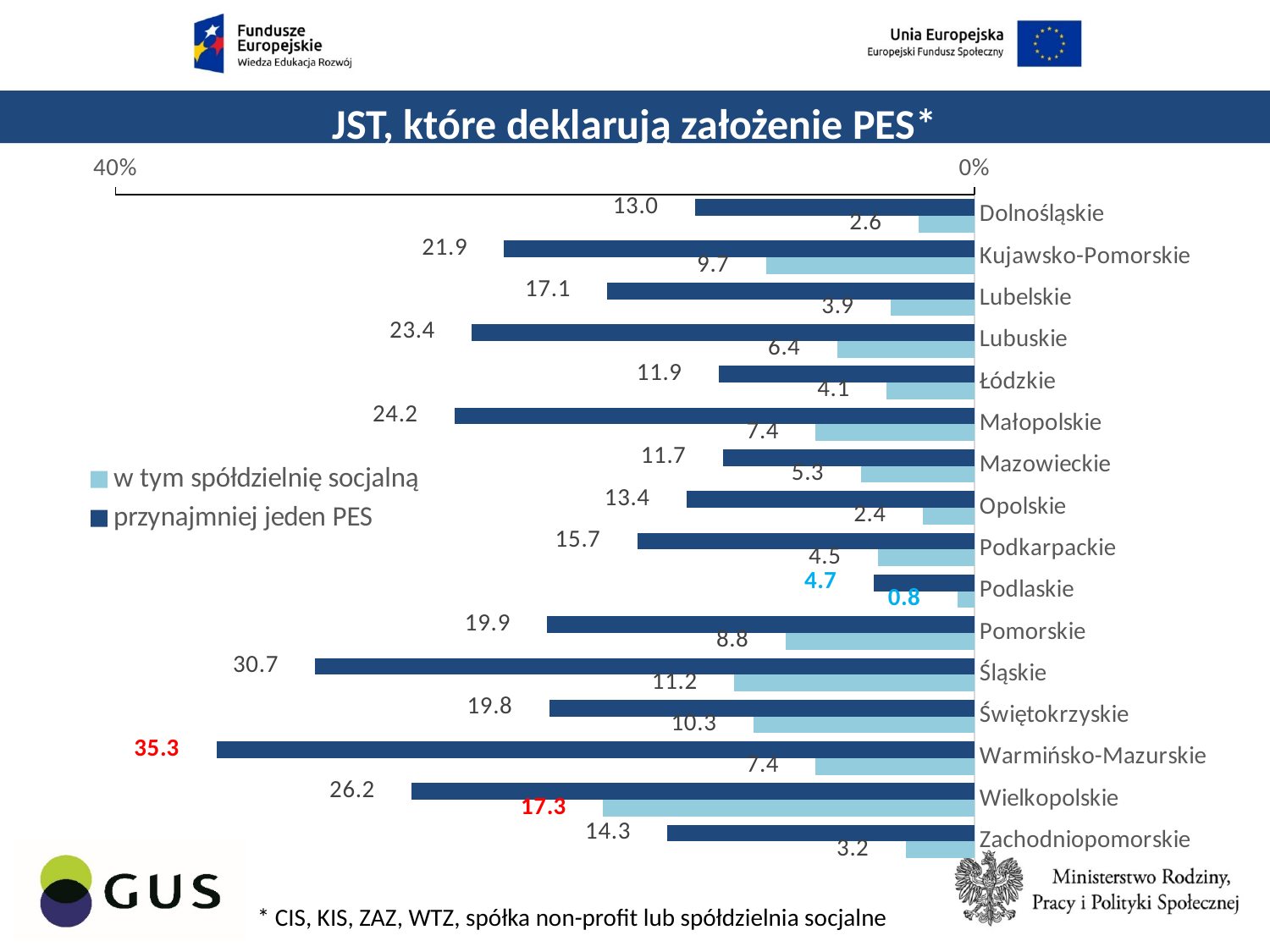
Which is larger: the "przynajmniej jeden PES" value for Małopolskie or for Lubuskie? Małopolskie Which voivodeship has the highest value for "przynajmniej jeden PES"? Warmińsko-Mazurskie What is the value of "przynajmniej jeden PES" for Śląskie? 30.7 How many series does the legend list? 2 How many voivodeships are shown in the chart? 16 What is the value of "w tym spółdzielnię socjalną" for Wielkopolskie? 17.3 Which voivodeship has the lowest value for "w tym spółdzielnię socjalną"? Podlaskie What is the title of the chart? JST, które deklarują założenie PES* What is the value of "w tym spółdzielnię socjalną" for Kujawsko-Pomorskie? 9.7 What is the difference between the "przynajmniej jeden PES" values for Warmińsko-Mazurskie and Wielkopolskie? 9.1 What is the difference between the "przynajmniej jeden PES" value and the "w tym spółdzielnię socjalną" value for Śląskie? 19.5 What kind of chart is shown on the slide? Bar chart